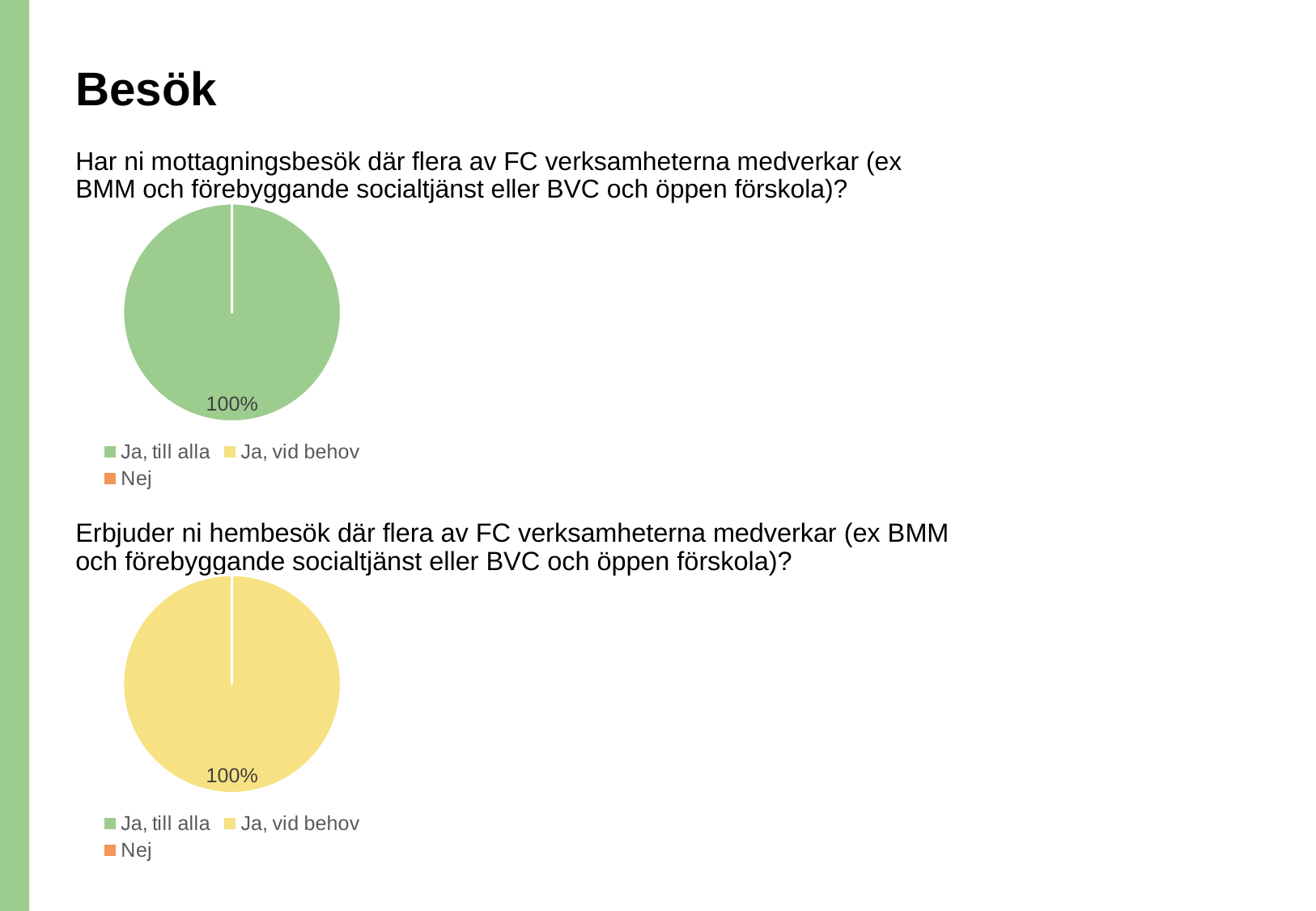
What colour is the slice shown in the bottom chart? yellow In the bottom chart, which category makes up the whole pie? Ja, vid behov In the bottom chart, what is the data label printed on the pie? 100% What kind of chart is the top chart on the slide? pie chart In the top chart (mottagningsbesök), what share does the 'Ja, till alla' slice have? 100% In the top chart, what is the data label printed on the pie? 100% How many entries does the legend of the bottom chart list? 3 In the bottom chart (hembesök), what share does the 'Ja, vid behov' slice have? 100% Which legend entry in the top chart is shown with an orange marker? Nej What kind of chart is the bottom chart on the slide? pie chart In the top chart, which category makes up the whole pie? Ja, till alla How many entries does the legend of the top chart list? 3